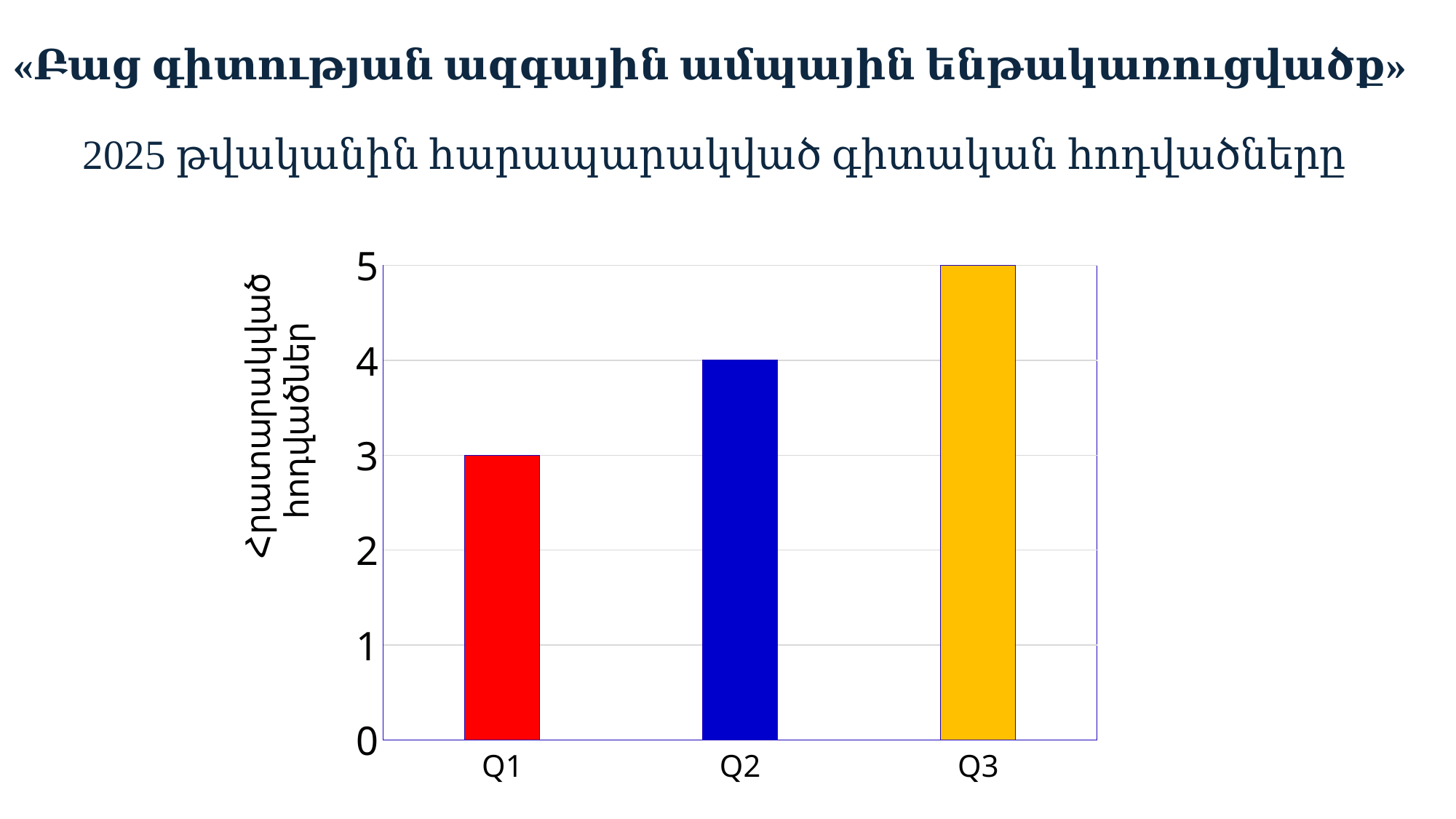
What is the value for Q1? 3 Do the values rise or fall from Q1 to Q3? rise Which is larger, the value for Q2 or the value for Q1? Q2 What colour is the bar for Q3? yellow What is the value for Q2? 4 What is the value for Q3? 5 Is the value for Q2 greater or less than 3? greater What is the difference between the values for Q3 and Q1? 2 Which quarter has the highest value? Q3 Which quarter has the lowest value? Q1 How many quarters are shown on the x axis? 3 What kind of chart is shown on the slide? bar chart